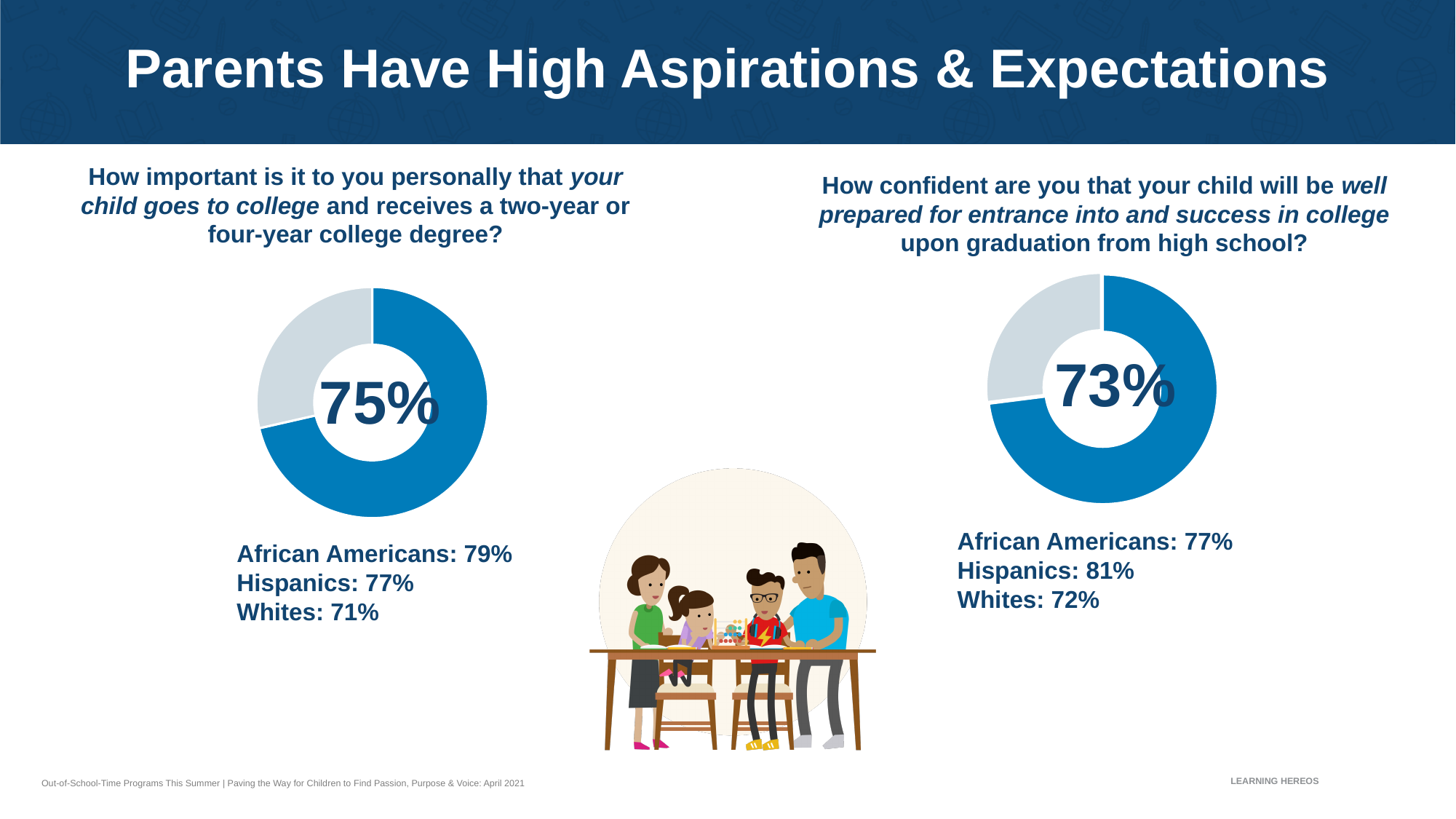
What kind of chart is used on the left side of the slide to show the 75% value? Donut chart Below the left donut chart, what percentage is listed for Hispanics? 77% Is the value shown in the right donut chart greater or less than 50%? greater Below the right donut chart, which group has the highest listed percentage? Hispanics (81%) What colour is used for the larger segment in both donut charts? Blue In the right donut chart, what share of the ring is filled in dark blue? 73% What percentage is shown in the center of the right donut chart about confidence that your child will be well prepared for college? 73% What is the difference between the percentage in the left donut chart and the percentage in the right donut chart? 2 percentage points What percentage is shown in the center of the left donut chart about how important it is that your child goes to college? 75% Which chart shows the larger highlighted percentage, the left chart (college importance) or the right chart (confidence in preparation)? The left chart (75%) How many segments does each donut chart on the slide have? 2